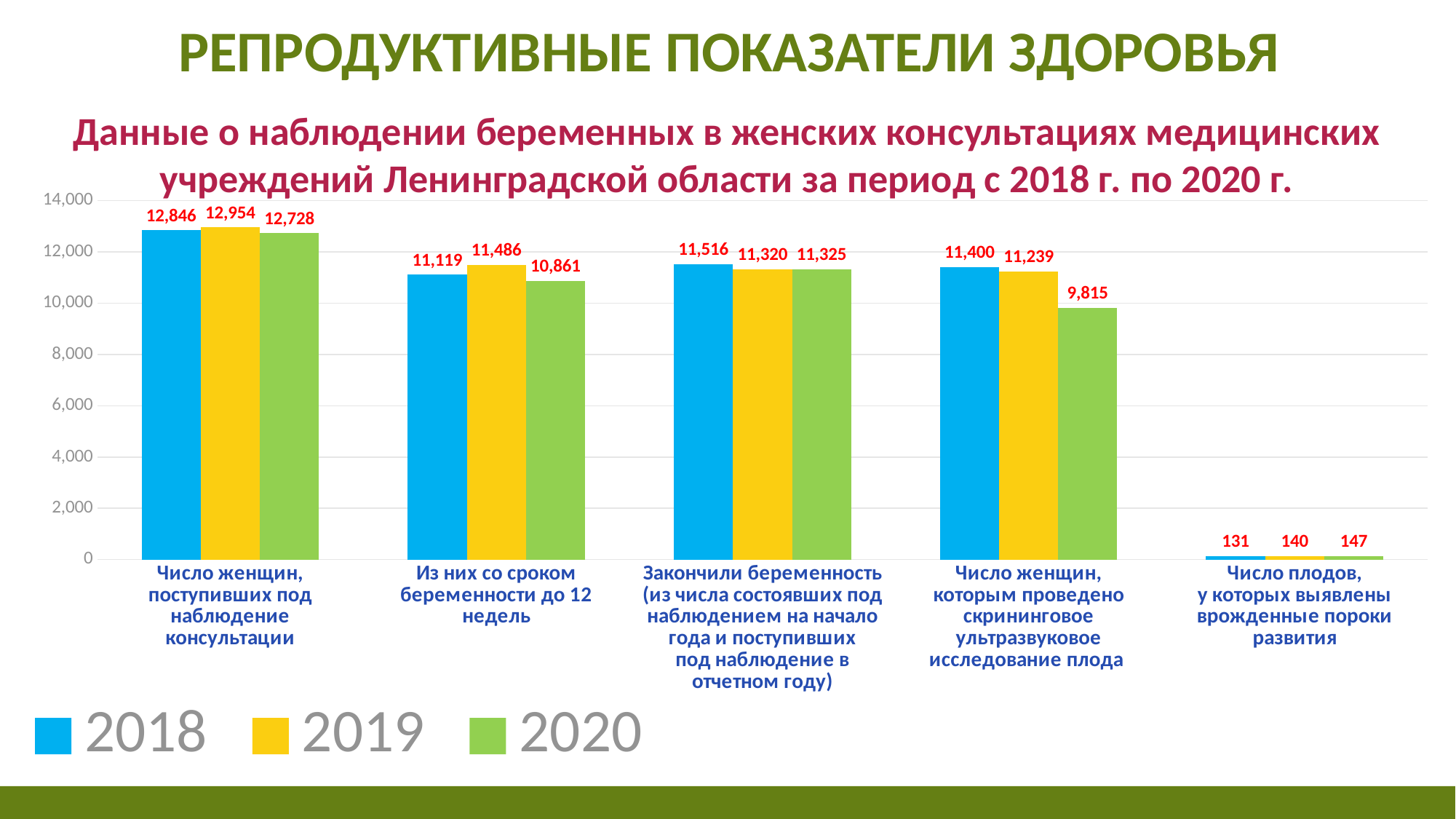
What is the 2019 value for "Число женщин, поступивших под наблюдение консультации"? 12,954 How many categories are shown on the x axis? 5 What is the 2020 value for "Число женщин, которым проведено скрининговое ультразвуковое исследование плода"? 9,815 Which year has the highest value for "Из них со сроком беременности до 12 недель"? 2019 Which year has the lowest value for "Число женщин, которым проведено скрининговое ультразвуковое исследование плода"? 2020 Which colour represents 2020 in the legend? Green What is the 2018 value for "Число плодов, у которых выявлены врожденные пороки развития"? 131 Which is larger: the 2018 value or the 2019 value for "Закончили беременность"? 2018 What is the difference between the 2018 and 2020 values for "Число женщин, которым проведено скрининговое ультразвуковое исследование плода"? 1,585 What is the 2020 value for "Из них со сроком беременности до 12 недель"? 10,861 What kind of chart is shown on the slide? Bar chart How many series does the legend list? 3